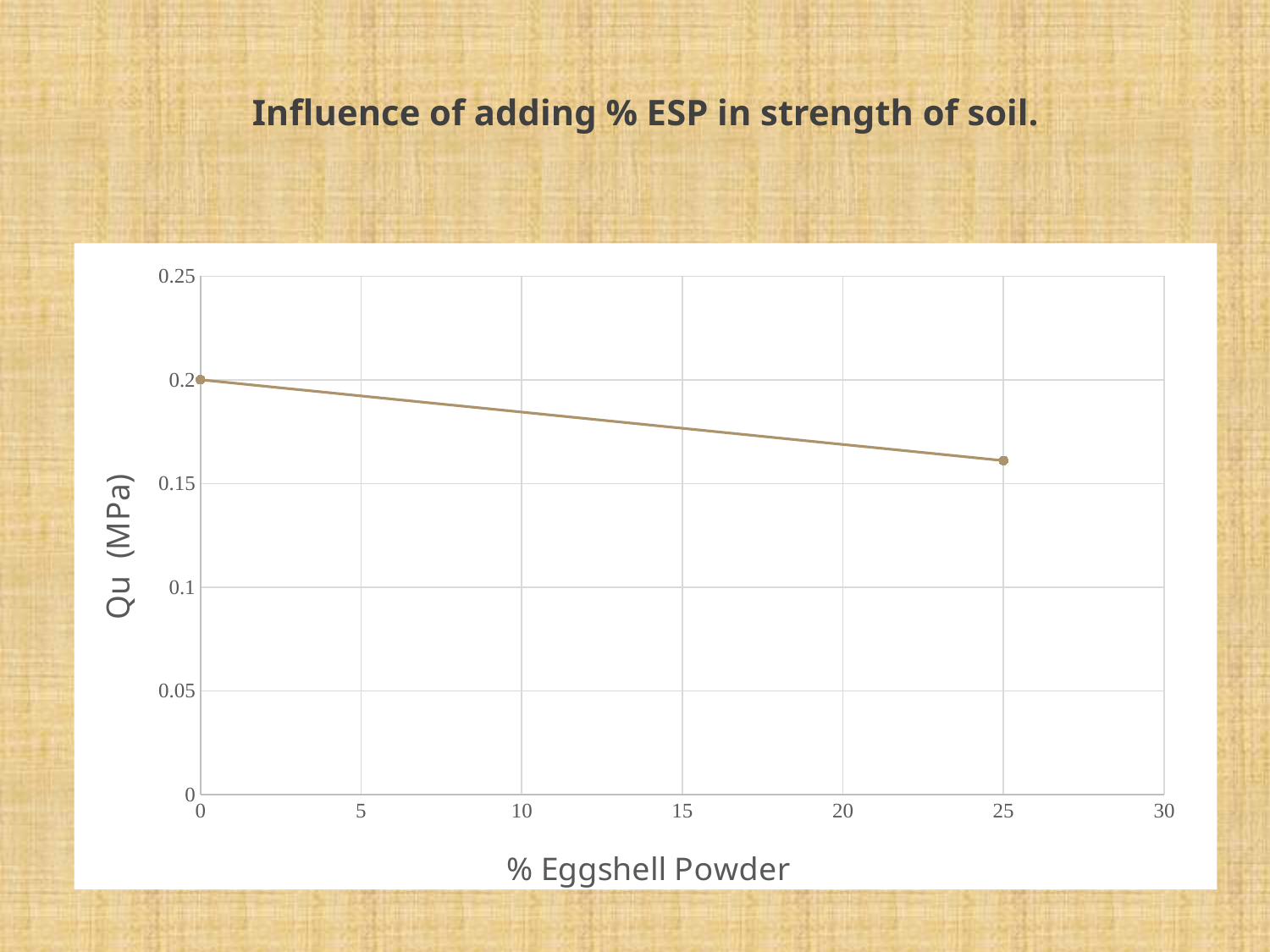
Is the Qu value at 25% eggshell powder greater or less than 0.2? less At which % eggshell powder is Qu highest? 0 Does Qu rise or fall as the % eggshell powder increases? fall What is the Qu value at 0% eggshell powder? 0.2 Which has the larger Qu value: 0% eggshell powder or 25% eggshell powder? 0% eggshell powder At which % eggshell powder is Qu lowest? 25 What kind of chart is shown on the slide? line chart Is the Qu value at 25% eggshell powder greater or less than 0.15? greater What is the label of the y axis? Qu (MPa) What is the label of the x axis? % Eggshell Powder How many data points are plotted on the chart? 2